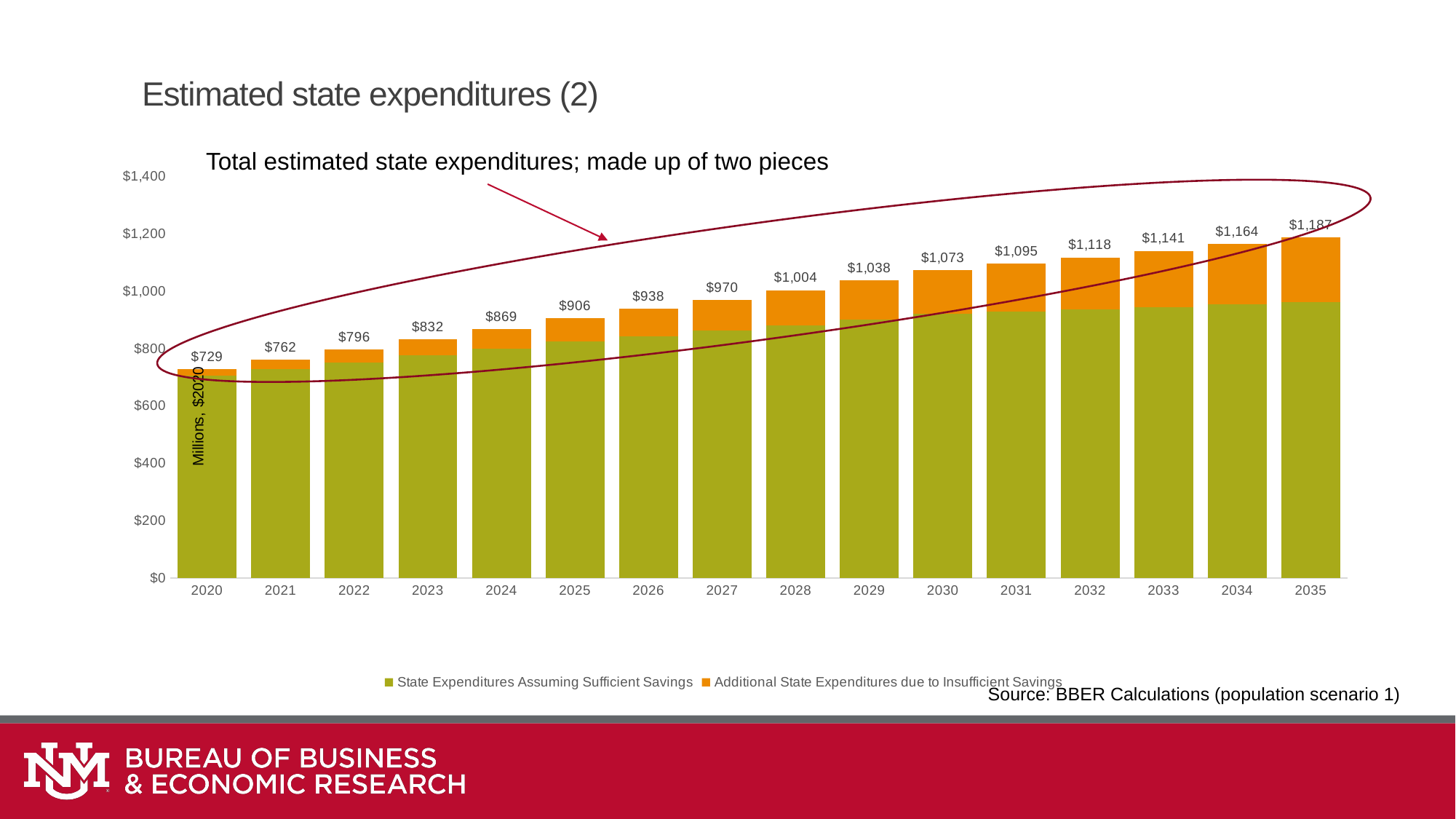
Do the total estimated state expenditures rise or fall from 2020 to 2035? rise What is the difference between the total estimated state expenditures for 2035 and 2020? $458 Which year has a larger total estimated state expenditure, 2024 or 2027? 2027 What is the total estimated state expenditure for 2035? $1,187 What is the difference between the total estimated state expenditures for 2030 and 2025? $167 How many series does the legend list? 2 What is the total estimated state expenditure for 2020? $729 How many years are shown on the x axis of the chart? 16 What is the total estimated state expenditure for 2028? $1,004 Which year has the highest total estimated state expenditure? 2035 Is the value for State Expenditures Assuming Sufficient Savings in 2035 greater or less than $1,000? less Which year has the lowest total estimated state expenditure? 2020